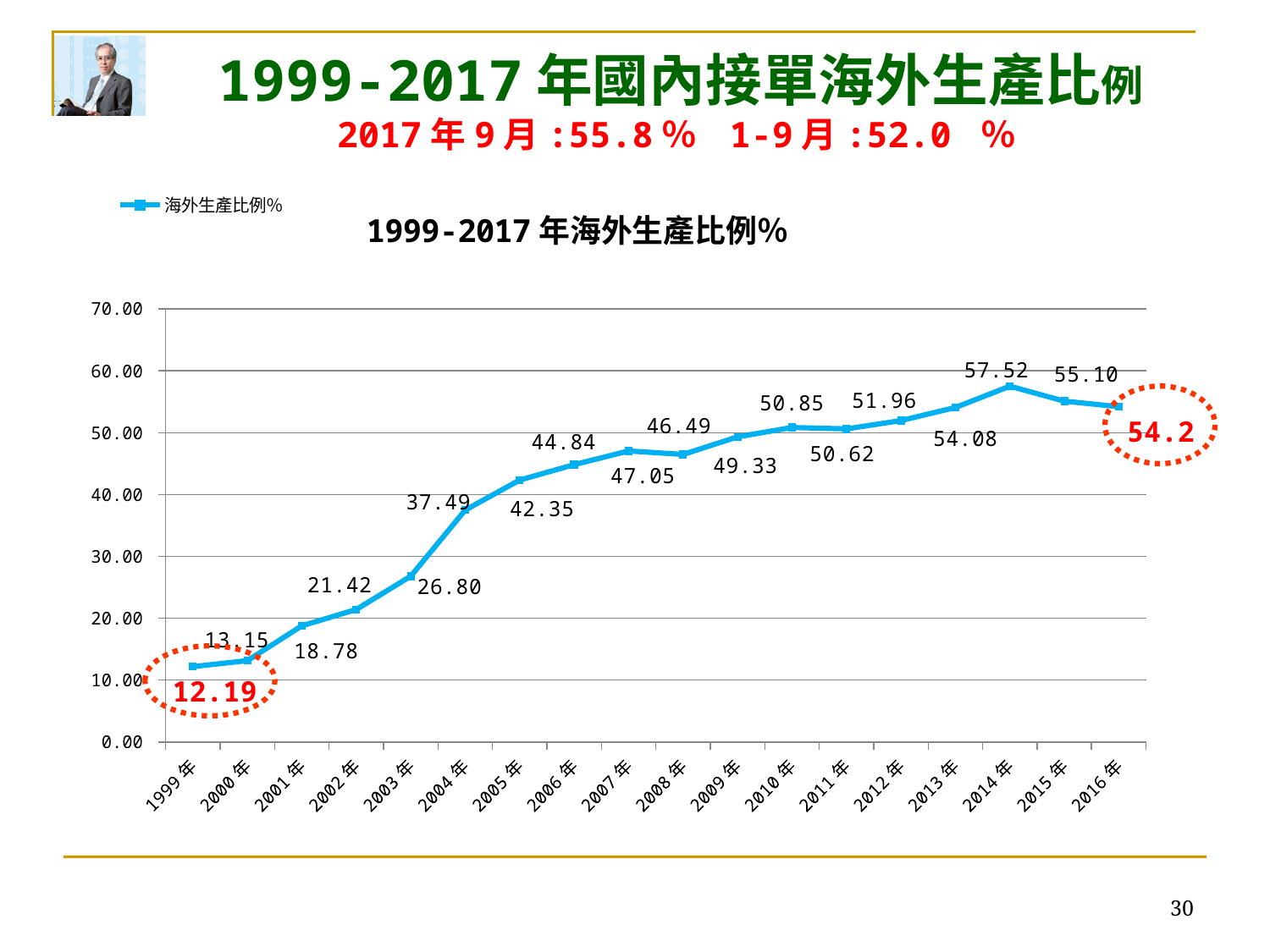
What is the difference between the values for 2014年 and 2015年? 2.42 What is the value plotted for 2016年? 54.2 Which year has the lowest plotted value? 1999年 What is the value plotted for 2004年? 37.49 What type of chart is shown on the slide? line chart How many series does the legend list? 1 How many years are plotted on the x axis? 18 What is the overseas production ratio value for 1999年? 12.19 Which year has the highest plotted value? 2014年 What is the value plotted for 2014年? 57.52 Which is larger, the value for 2007年 or the value for 2008年? 2007年 Is the value for 2003年 greater or less than 30.00? less